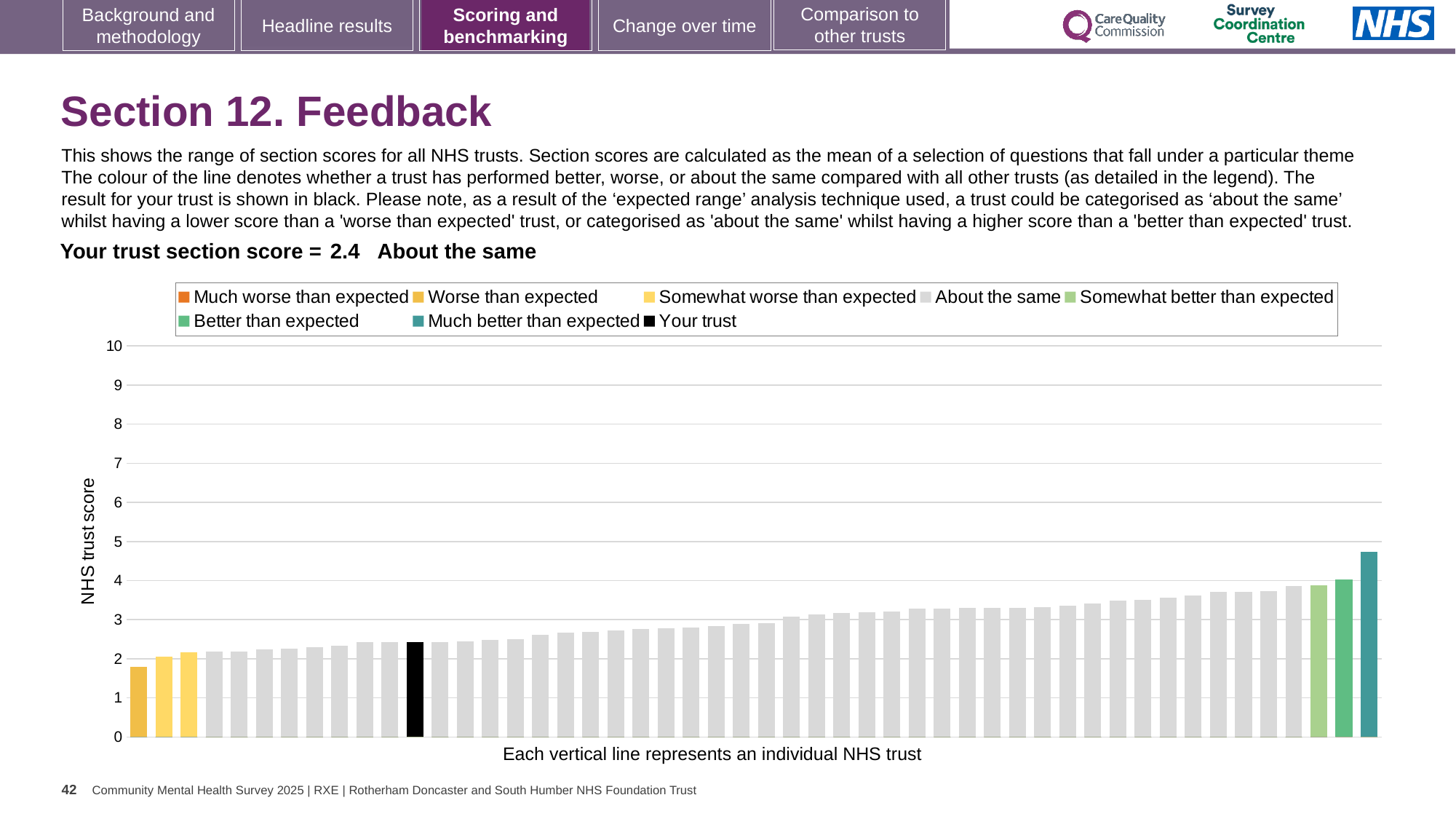
What kind of chart is shown on the slide? bar chart Is the value for your trust's bar greater or less than 3? less Is the value of the tallest bar (the rightmost, teal bar) greater or less than 4? greater Which category is your trust's section score placed in? About the same What is the title of the vertical axis? NHS trust score How many bars are coloured as 'Much better than expected'? 1 Which legend category does the tallest bar belong to? Much better than expected Is the value of the leftmost bar greater or less than 2? less Do the bar values rise or fall moving from left to right along the x axis? rise How many entries does the chart legend list? 8 What is the section score for your trust shown on the slide? 2.4 Which is larger, the leftmost bar or your trust's black bar? your trust's black bar